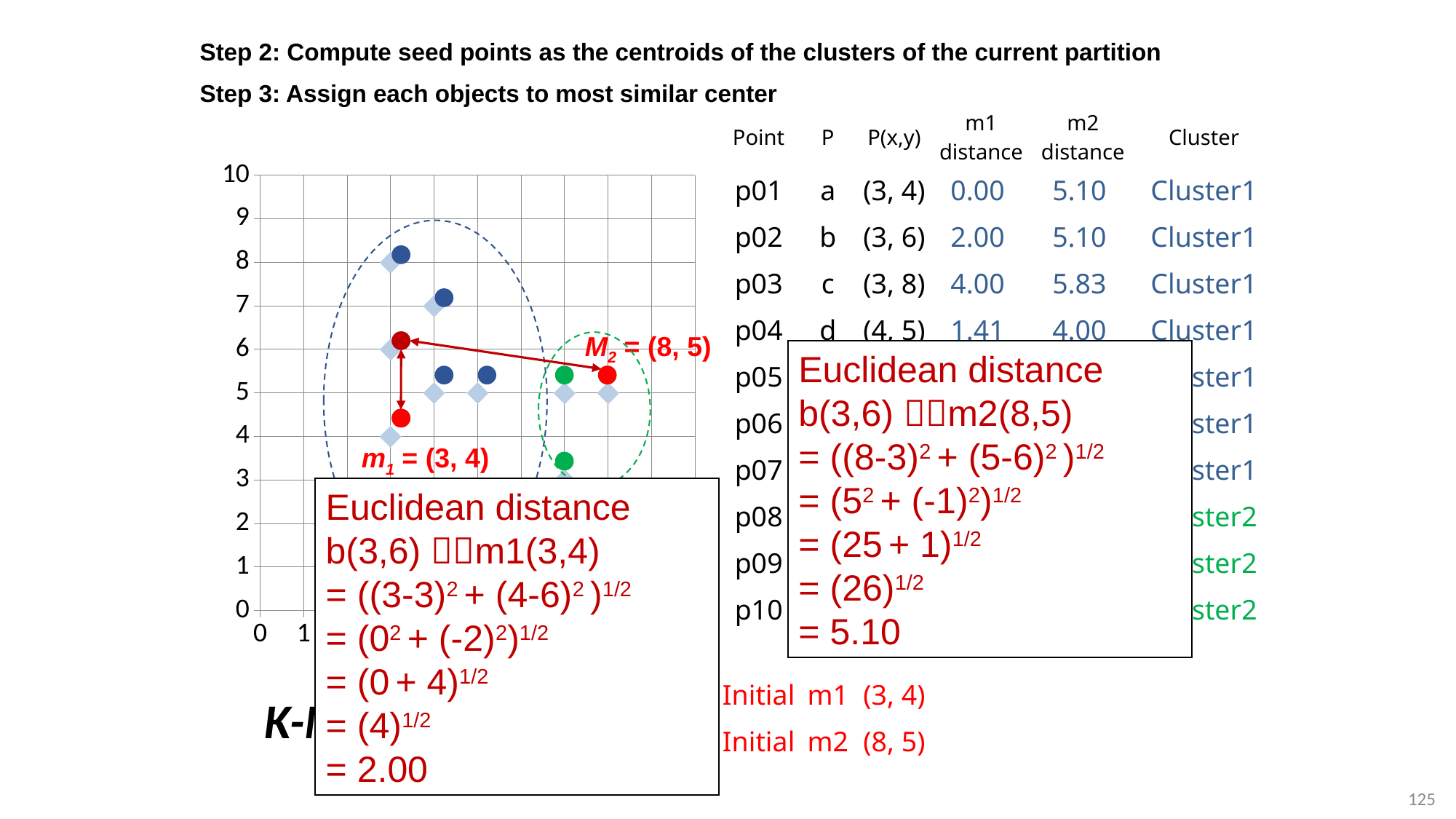
In the table, what is the m1 distance for point b (p02)? 2.00 In the table, what are the P(x,y) coordinates of point d (p04)? (4, 5) Is the y value of the point labelled M2 greater or less than 6? less Is the y value of the highest blue point on the scatter chart greater or less than 7? greater In the table, which is larger for point a (p01): the m1 distance or the m2 distance? m2 distance What coordinates are given for M2 on the scatter chart? (8, 5) What is the highest value shown on the y axis of the scatter chart? 10 What coordinates are given for m1 on the scatter chart? (3, 4) In the table, what is the m2 distance for point c (p03)? 5.83 Which cluster is point d (p04) assigned to in the table? Cluster1 In the table, what is the difference between the m2 distance and the m1 distance for point c (p03)? 1.83 What kind of chart is shown on the left of the slide? scatter chart